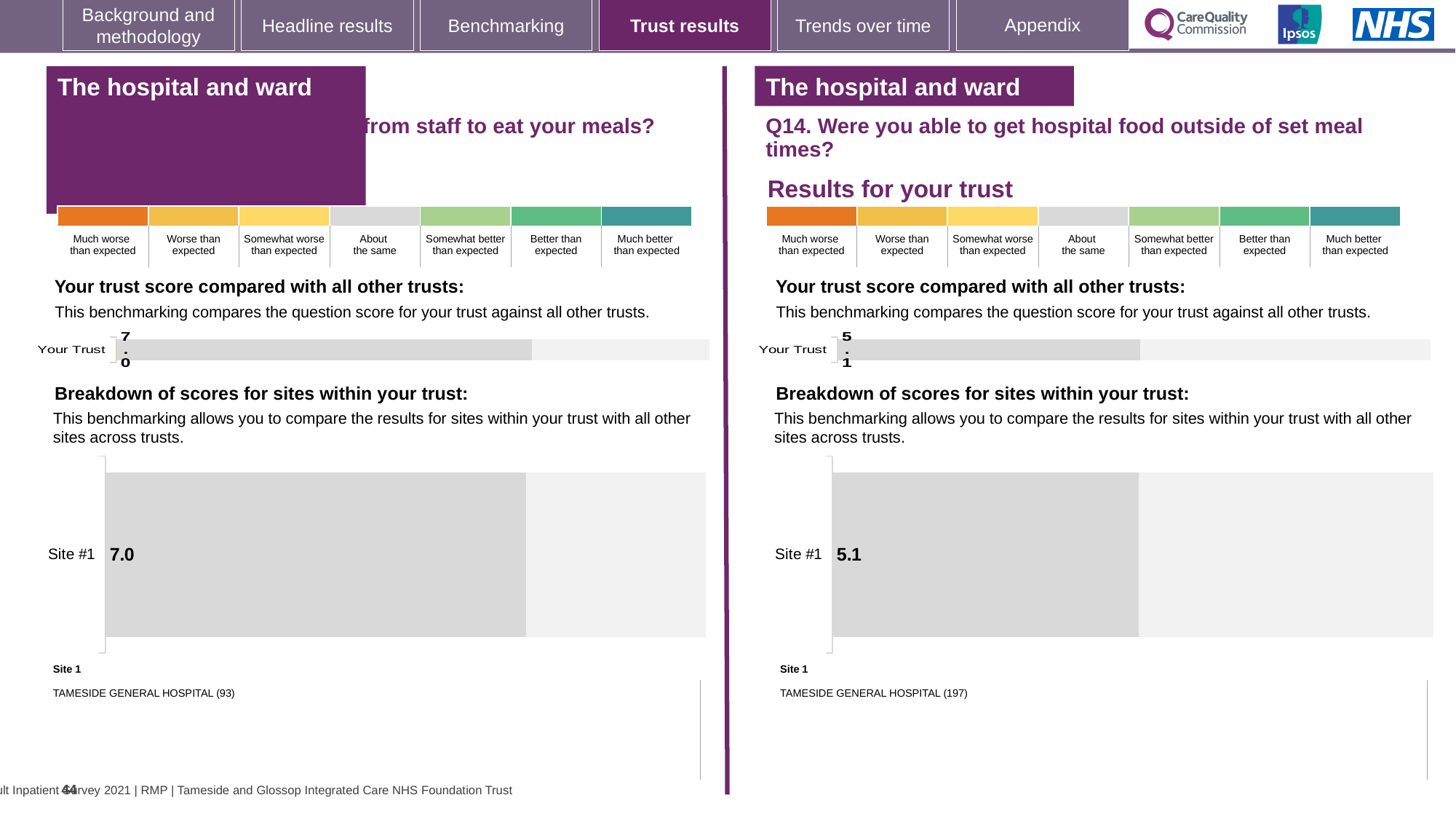
Is the Your Trust score on the right panel (Q14) greater or less than 7.0? less Which is larger: the Site #1 score on the left panel or the Site #1 score on the right panel (Q14)? Left panel (7.0) On the right panel (Q14), what is the score for Site #1 in the 'Breakdown of scores for sites within your trust' chart? 5.1 On the right panel (Q14), which site is listed as Site 1 below the chart? TAMESIDE GENERAL HOSPITAL (197) On the right panel (Q14), what is the score shown for Your Trust in the 'Your trust score compared with all other trusts' chart? 5.1 How many sites are shown in the 'Breakdown of scores for sites within your trust' chart on the right panel (Q14)? 1 On the left panel, what number appears in brackets after TAMESIDE GENERAL HOSPITAL in the Site 1 label? 93 What type of chart is used to show the Site #1 score on the right panel (Q14)? Bar chart On the left panel, what is the score shown for Your Trust in the 'Your trust score compared with all other trusts' chart? 7.0 What is the difference between the Site #1 score on the left panel and the Site #1 score on the right panel (Q14)? 1.9 On the left panel, what is the score for Site #1 in the 'Breakdown of scores for sites within your trust' chart? 7.0